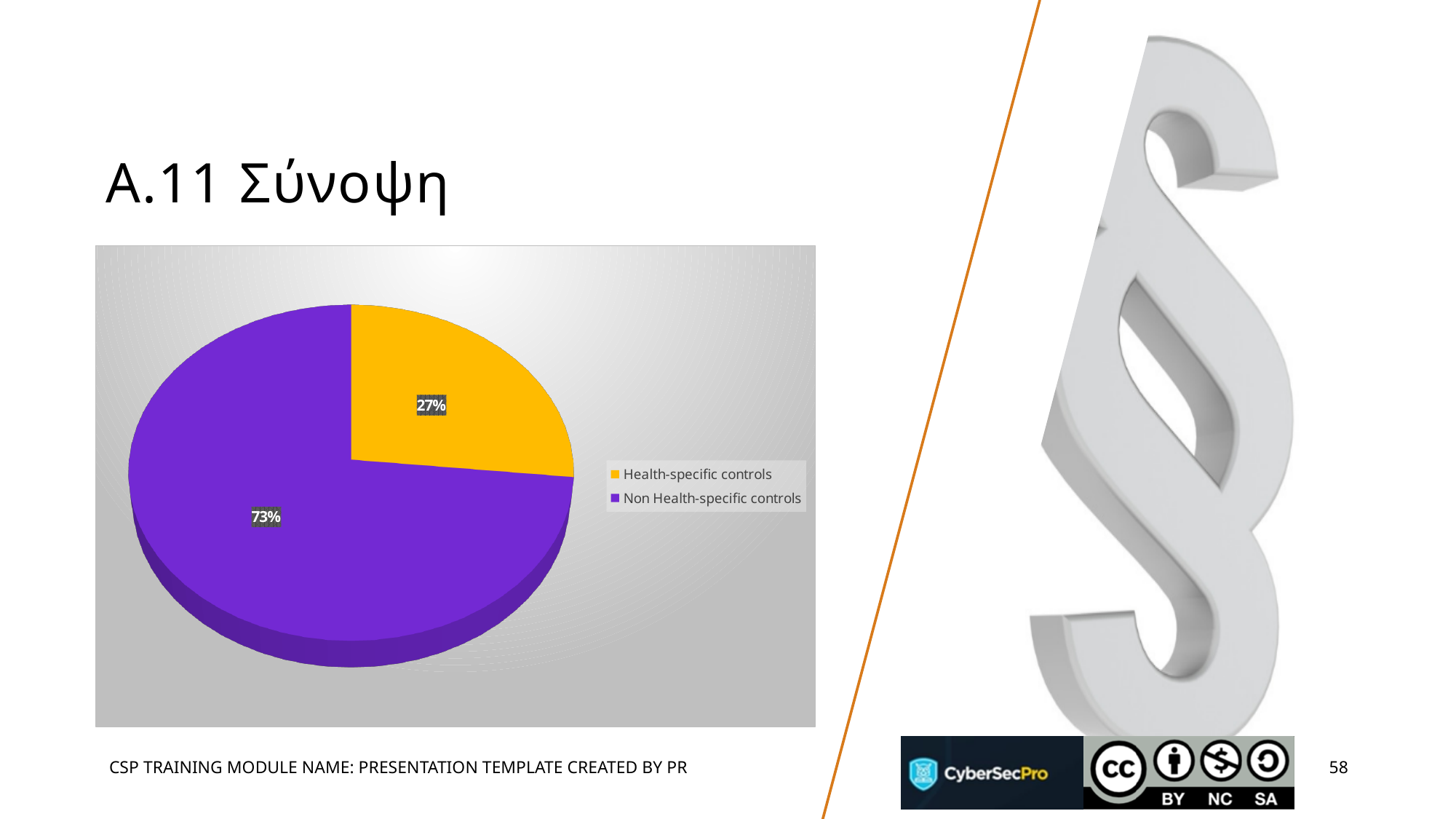
What share of the pie is Health-specific controls? 27% How many entries does the legend list? 2 What colour is the slice for Non Health-specific controls? purple What kind of chart is shown on the slide? pie chart Which is larger, the share for Health-specific controls or for Non Health-specific controls? Non Health-specific controls How many slices does the pie chart have? 2 Which category has the largest slice of the pie? Non Health-specific controls Which category has the smallest slice of the pie? Health-specific controls What share of the pie is Non Health-specific controls? 73% What colour is the slice for Health-specific controls? orange What is the difference in percentage points between Non Health-specific controls and Health-specific controls? 46